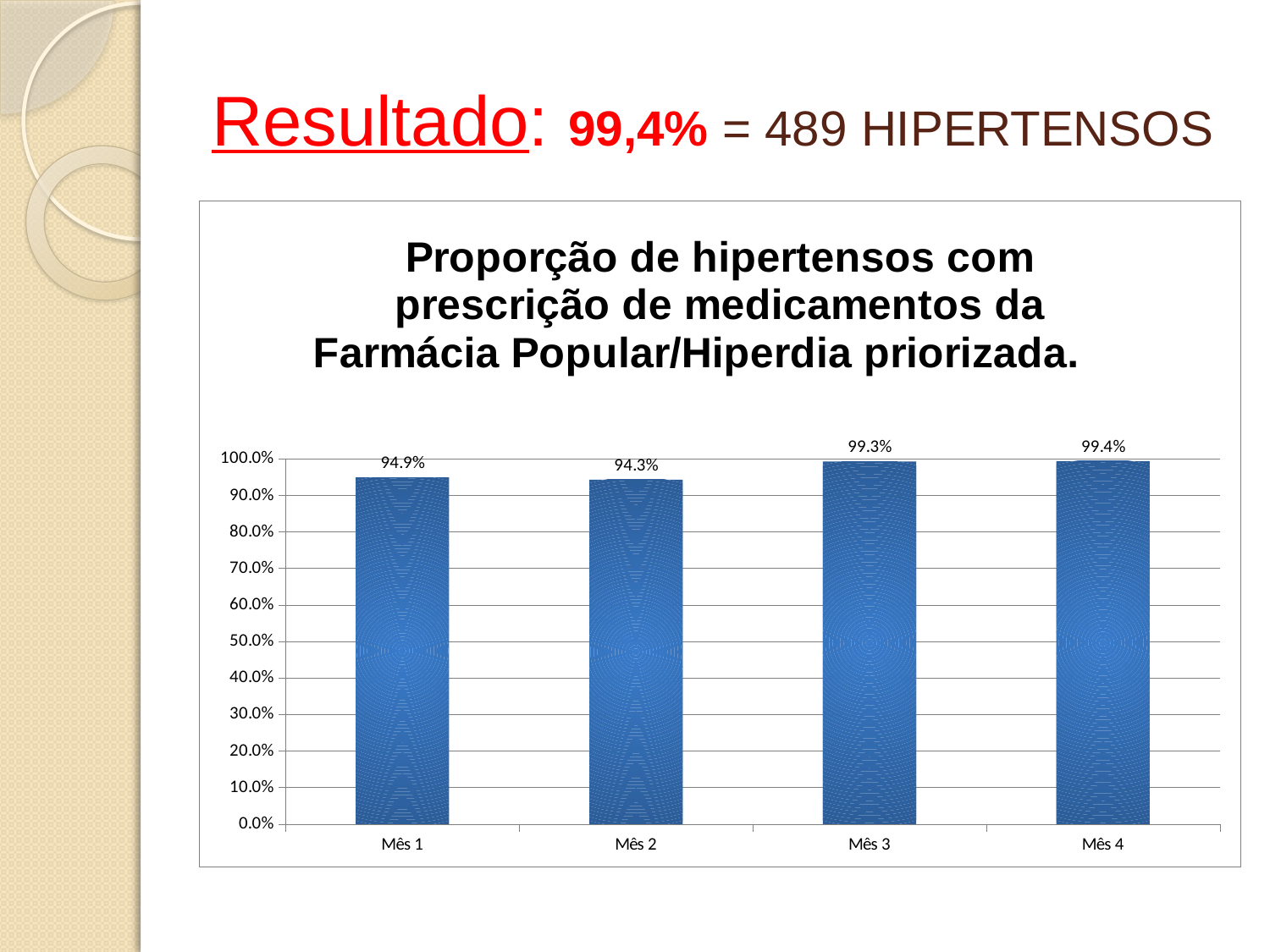
Which month has the lowest value? Mês 2 What is the difference between the values for Mês 3 and Mês 1? 4.4% What is the value for Mês 3? 99.3% Is the value for Mês 2 greater or less than 90.0%? greater What is the title of the chart? Proporção de hipertensos com prescrição de medicamentos da Farmácia Popular/Hiperdia priorizada. What is the difference between the values for Mês 1 and Mês 2? 0.6% Which is larger, the value for Mês 2 or the value for Mês 3? Mês 3 What is the value for Mês 2? 94.3% What kind of chart is shown on the slide? bar chart What is the value for Mês 4? 99.4% What is the value for Mês 1? 94.9% How many months are shown on the x axis? 4